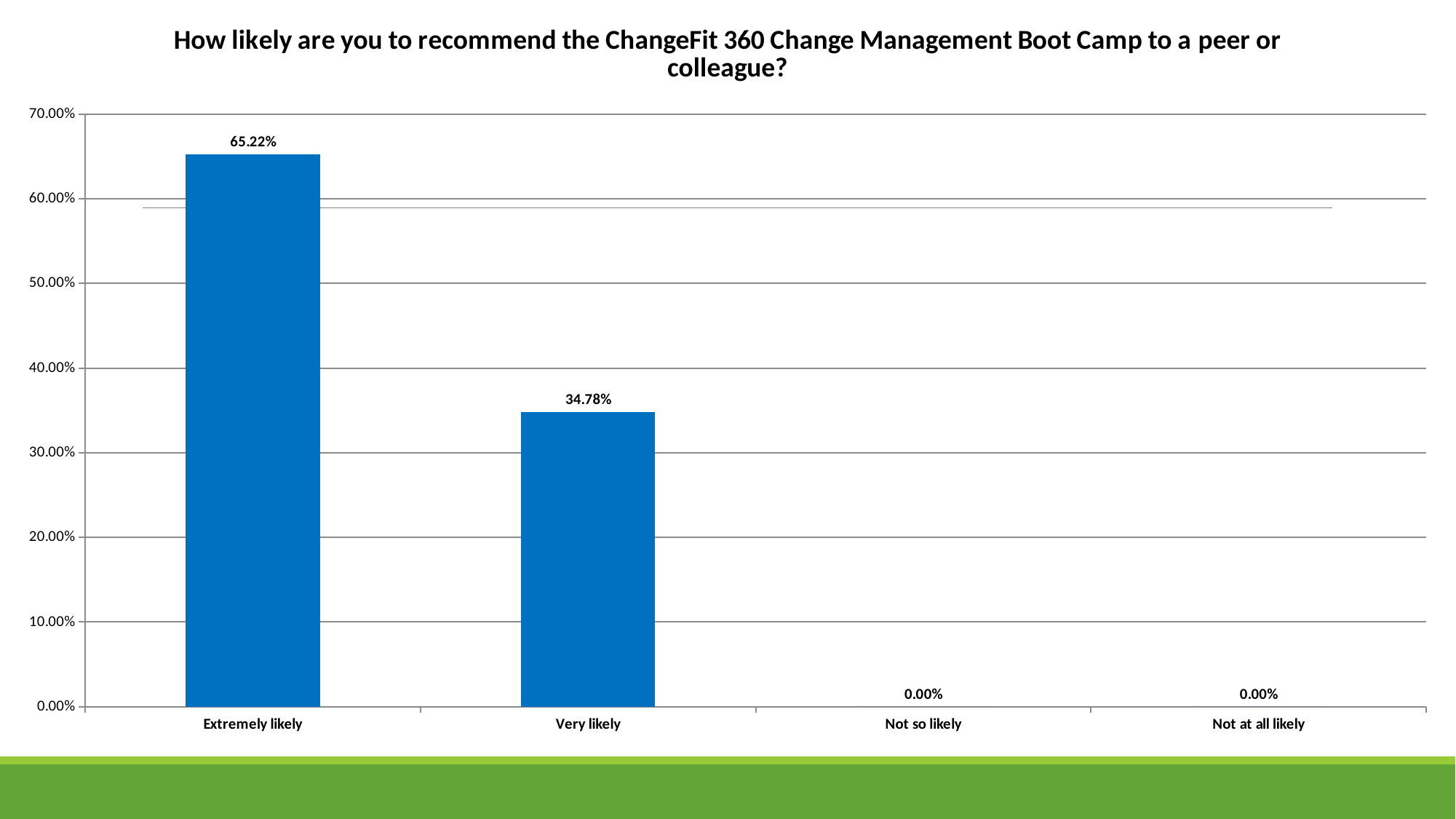
What is the value for Extremely likely? 65.22% What kind of chart is shown on the slide? Bar chart Which category has the highest value? Extremely likely Is the value for Very likely greater or less than 40.00%? less What is the value for Not so likely? 0.00% What is the value for Not at all likely? 0.00% How many categories are shown on the x axis? 4 Which is larger, the value for Extremely likely or the value for Very likely? Extremely likely Is the value for Extremely likely greater or less than 60.00%? greater What is the value for Very likely? 34.78% What is the title of the chart? How likely are you to recommend the ChangeFit 360 Change Management Boot Camp to a peer or colleague? What is the difference between the values for Extremely likely and Very likely? 30.44%